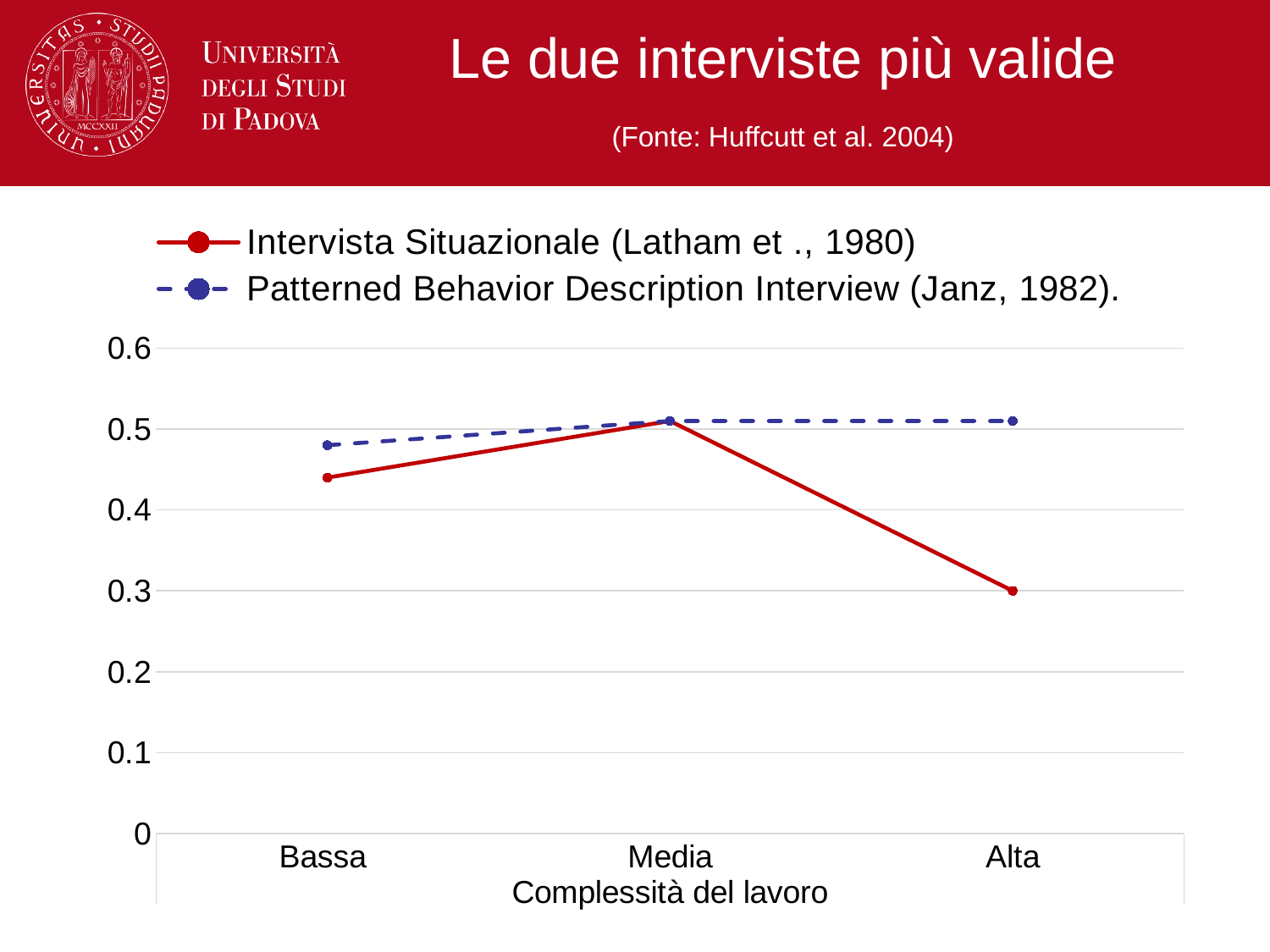
How many series does the legend list? 2 How many categories are shown on the x axis? 3 For which level of Complessità del lavoro is the Intervista Situazionale (Latham et ., 1980) value lowest? Alta What is the title of the x axis? Complessità del lavoro At Alta complexity, which series has the larger value? Patterned Behavior Description Interview (Janz, 1982) What kind of chart is shown on the slide? Line chart Does the Intervista Situazionale (Latham et ., 1980) line rise or fall from Media to Alta? Fall At Bassa complexity, which series has the larger value? Patterned Behavior Description Interview (Janz, 1982) For which level of Complessità del lavoro is the Patterned Behavior Description Interview (Janz, 1982) value lowest? Bassa For which level of Complessità del lavoro is the Intervista Situazionale (Latham et ., 1980) value highest? Media Is the value for Intervista Situazionale (Latham et ., 1980) at Bassa greater or less than 0.5? less